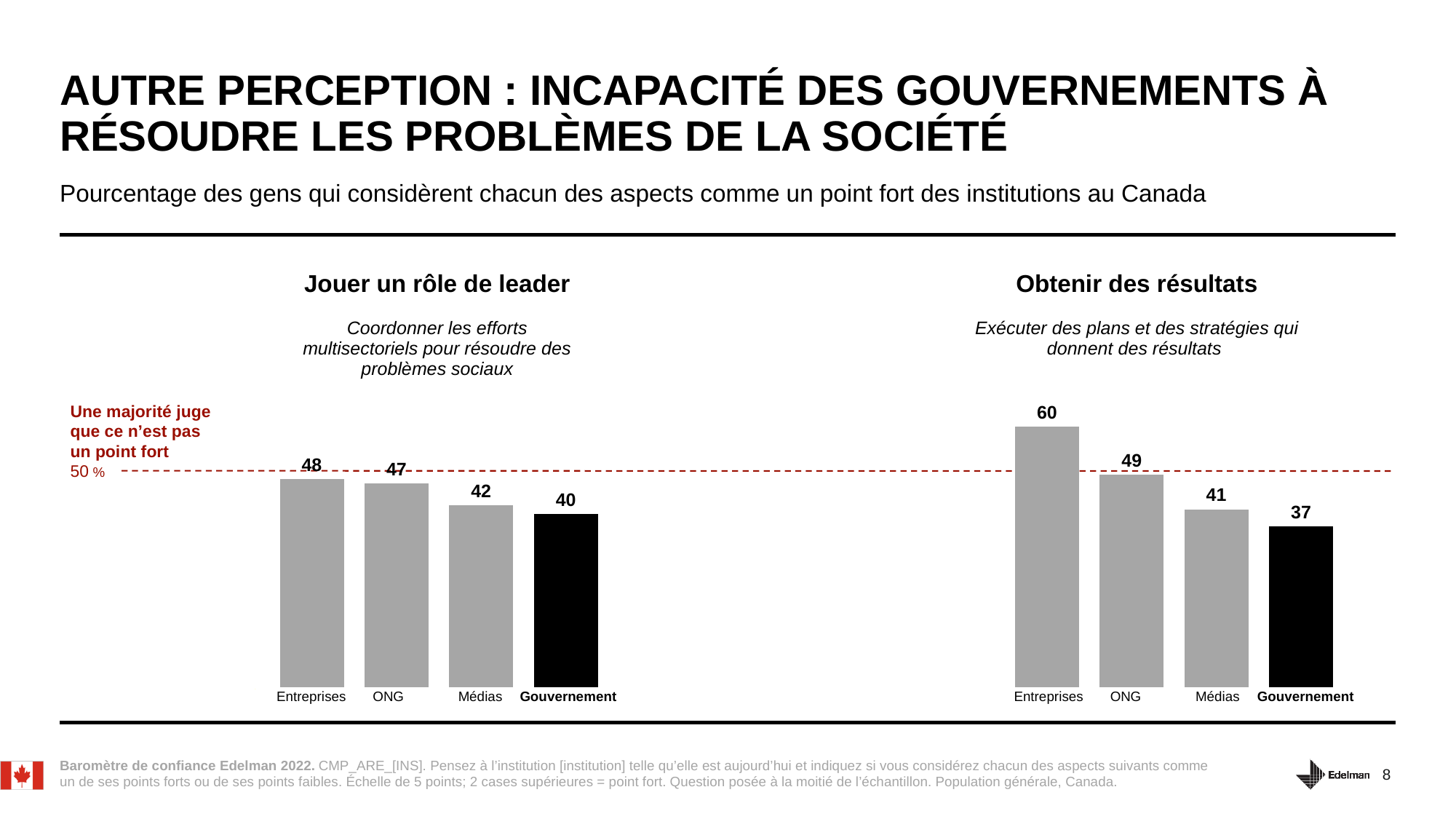
In the 'Obtenir des résultats' chart, is the value for Entreprises greater or less than 50? greater In the 'Jouer un rôle de leader' chart, do the values rise or fall from left to right? fall In the 'Jouer un rôle de leader' chart, which category has the highest value? Entreprises In the 'Obtenir des résultats' chart, what is the value for Entreprises? 60 What kind of chart is the 'Obtenir des résultats' chart? bar chart In the 'Jouer un rôle de leader' chart, what is the value for Gouvernement? 40 In the 'Jouer un rôle de leader' chart, what is the difference between the values for Entreprises and Gouvernement? 8 How many categories are shown in the 'Jouer un rôle de leader' chart? 4 In the 'Obtenir des résultats' chart, which category has the lowest value? Gouvernement In the 'Obtenir des résultats' chart, which is larger, the value for ONG or the value for Médias? ONG In the 'Obtenir des résultats' chart, what is the difference between the values for Entreprises and ONG? 11 In the 'Obtenir des résultats' chart, what is the value for Médias? 41